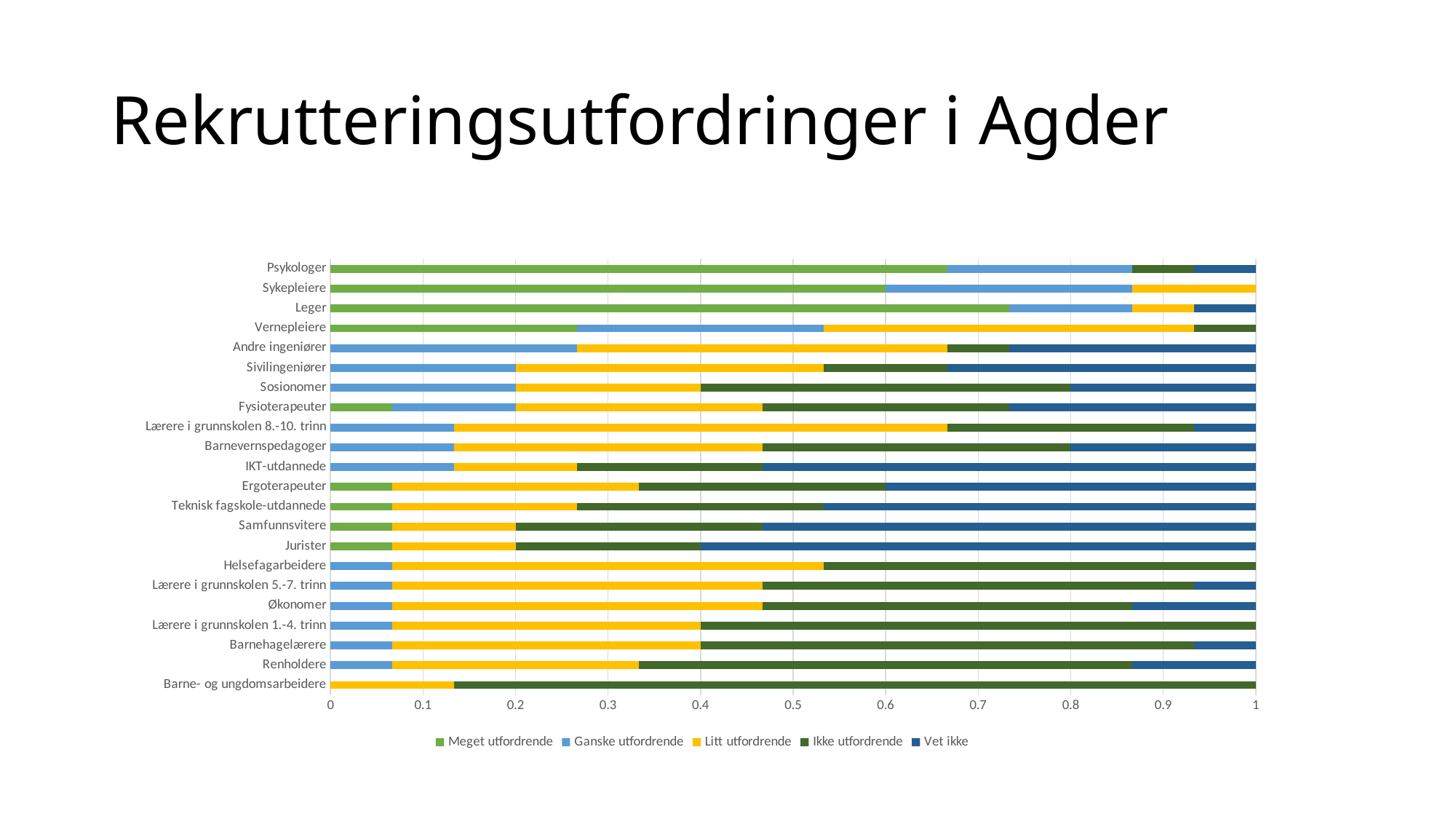
Which category has the largest 'Ikke utfordrende' segment? Barne- og ungdomsarbeidere Which category has the largest 'Meget utfordrende' segment? Leger Which series is shown in yellow in the legend? Litt utfordrende Is the 'Meget utfordrende' segment larger for Psykologer or for Sykepleiere? Psykologer What is the title of the slide? Rekrutteringsutfordringer i Agder What kind of chart is shown on the slide? Stacked bar chart How many series does the legend list? 5 Which category has the largest 'Vet ikke' segment? Jurister Is the 'Meget utfordrende' value for Vernepleiere greater or less than 0.3? less How many occupation categories are plotted on the chart? 22 Is the 'Meget utfordrende' value for Leger greater or less than 0.7? greater Is the 'Vet ikke' value for Jurister greater or less than 0.5? greater